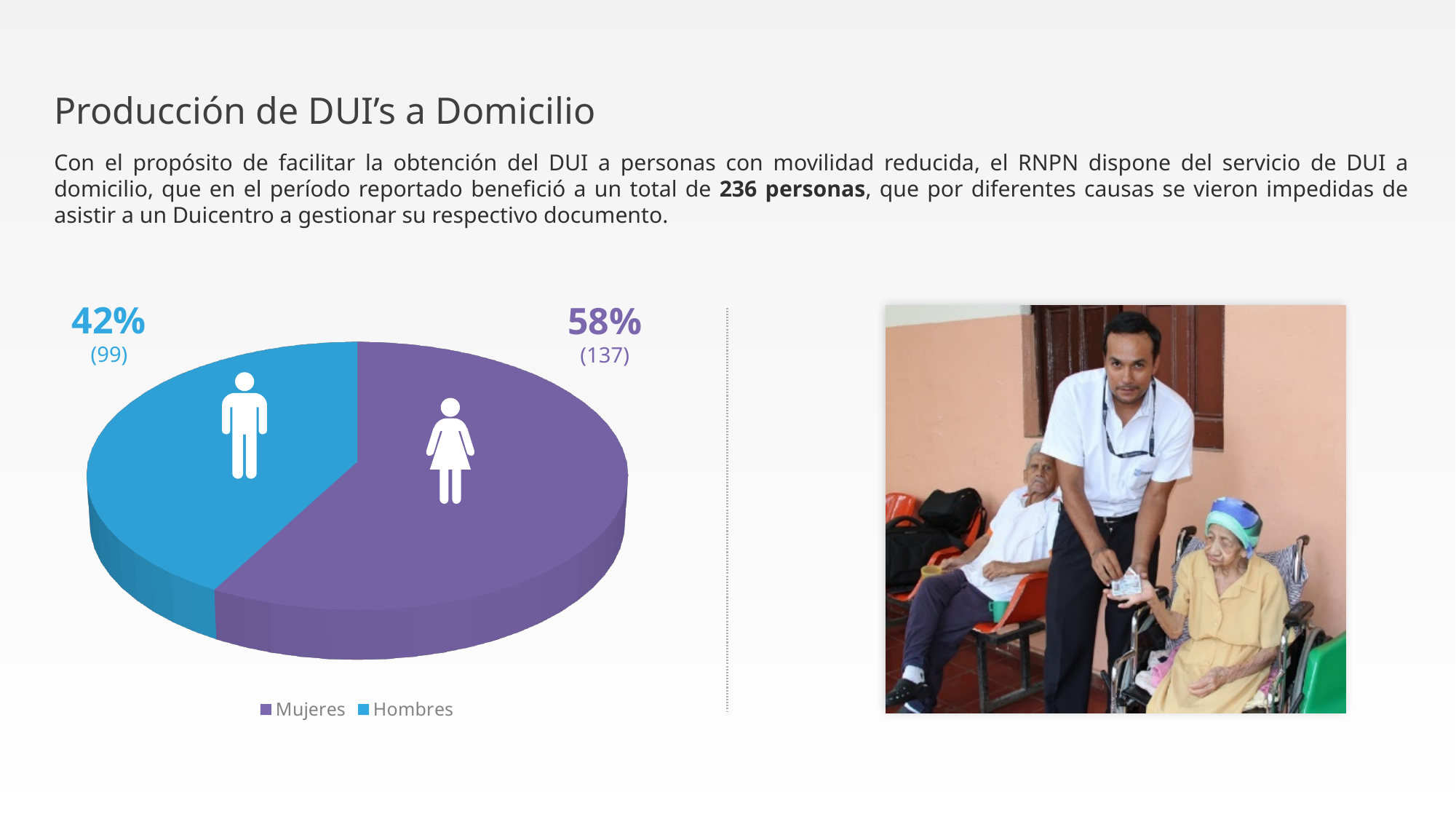
Which category has the largest slice of the pie chart? Mujeres How many slices does the pie chart have? 2 Which is larger, the Mujeres slice or the Hombres slice? Mujeres What is the difference in number of people between Mujeres and Hombres? 38 Which category has the smallest slice of the pie chart? Hombres What kind of chart is shown on the slide? pie chart How many people does the Hombres slice represent? 99 What percentage of the pie chart corresponds to Hombres? 42% What is the total number of people represented by the two slices of the pie chart? 236 What colour is the Hombres slice in the pie chart? blue What percentage of the pie chart corresponds to Mujeres? 58% How many people does the Mujeres slice represent? 137